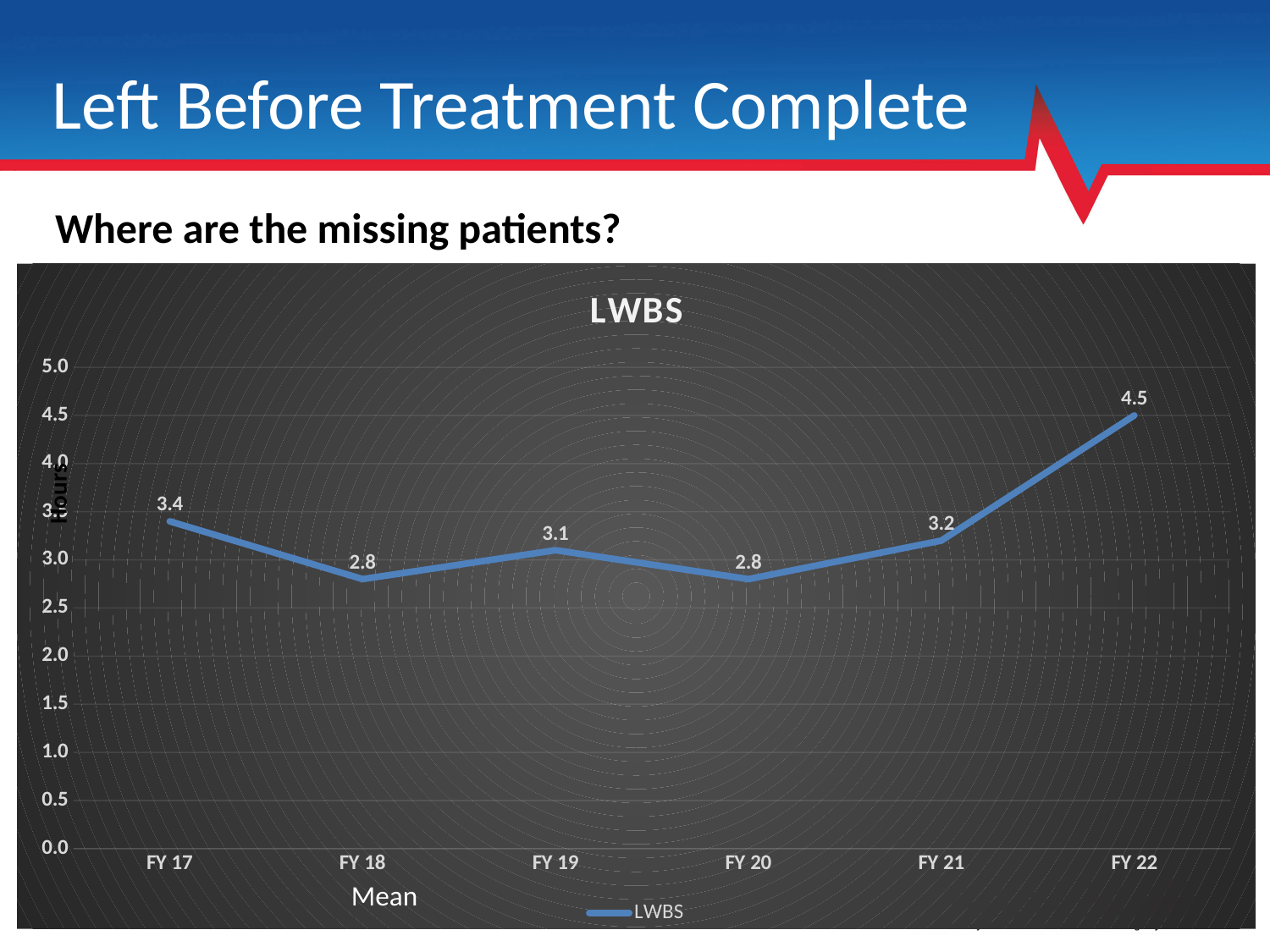
What is the LWBS value for FY 19? 3.1 What is the difference between the LWBS values for FY 22 and FY 21? 1.3 What kind of chart is shown on the slide? line chart What is the LWBS value for FY 17? 3.4 What is the LWBS value for FY 22? 4.5 Which fiscal year has the highest LWBS value? FY 22 What is the title of the chart? LWBS Is the LWBS value for FY 22 greater or less than 4.0? greater Do the LWBS values rise or fall from FY 20 to FY 22? rise How many series does the legend list? 1 Which is larger, the LWBS value for FY 17 or for FY 19? FY 17 How many fiscal years are plotted on the chart? 6